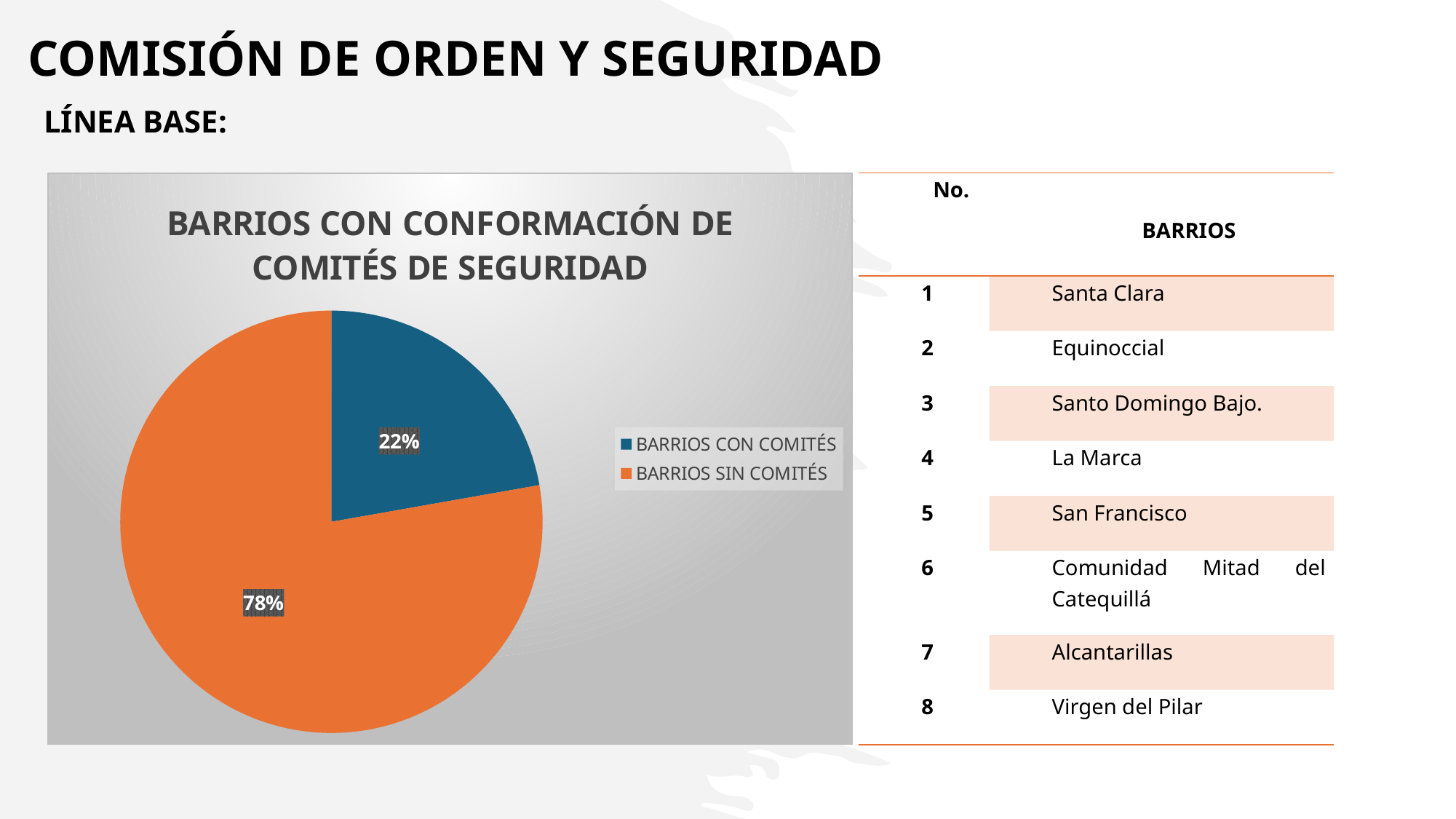
What percentage of the pie is BARRIOS CON COMITÉS? 22% What percentage of the pie is BARRIOS SIN COMITÉS? 78% Which slice is the smallest in the pie chart? BARRIOS CON COMITÉS What colour is the BARRIOS SIN COMITÉS slice? Orange What is the title of the chart? BARRIOS CON CONFORMACIÓN DE COMITÉS DE SEGURIDAD What is the difference in percentage points between BARRIOS SIN COMITÉS and BARRIOS CON COMITÉS? 56 What type of chart is shown on the slide? Pie chart Which is larger, BARRIOS CON COMITÉS or BARRIOS SIN COMITÉS? BARRIOS SIN COMITÉS How many entries does the legend list? 2 Which slice is the largest in the pie chart? BARRIOS SIN COMITÉS How many slices does the pie chart have? 2 What share of the pie does BARRIOS CON COMITÉS represent? 22%